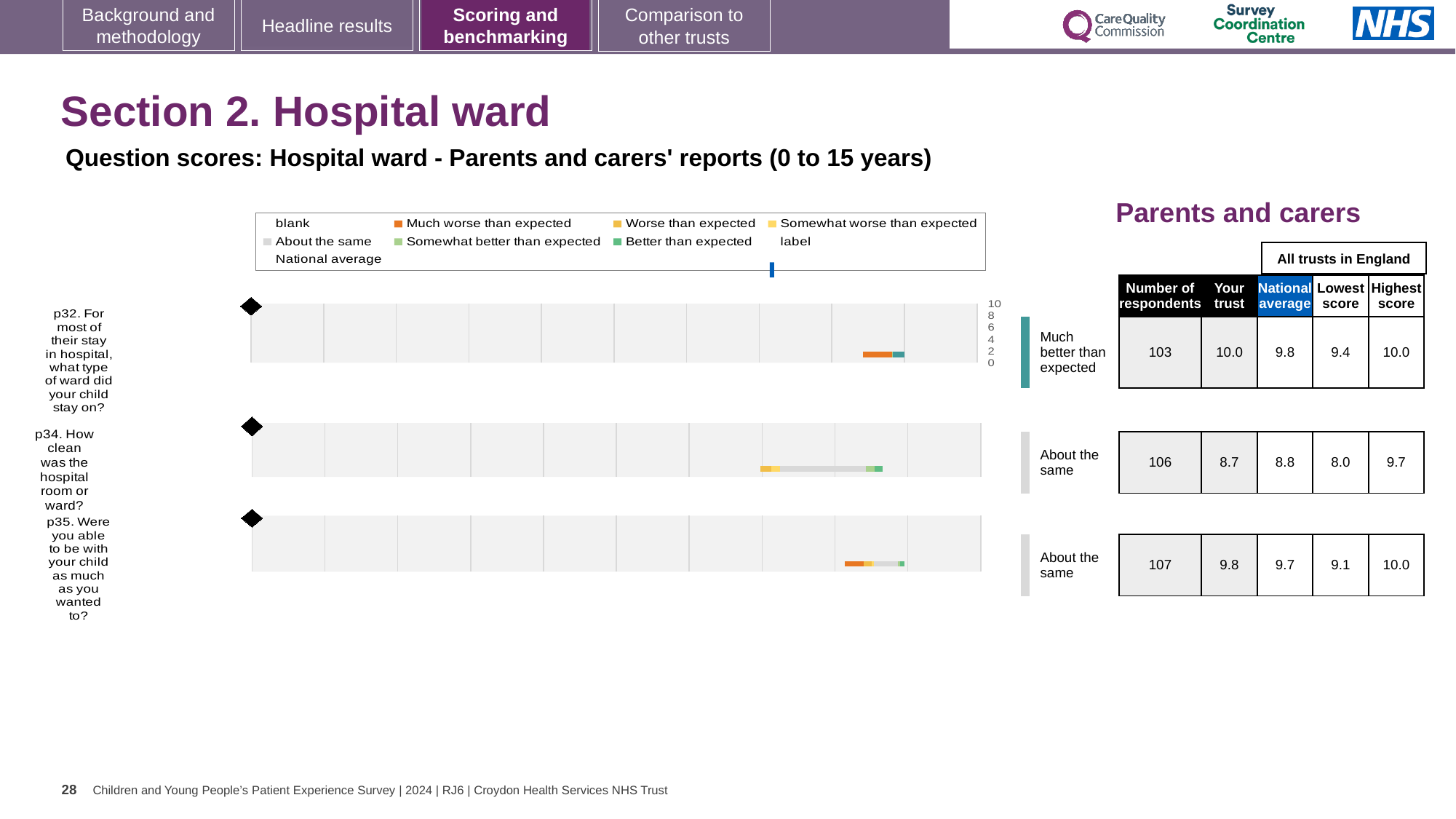
What is the difference between the highest score and the lowest score for p34? 1.7 What kind of chart is used to show the question scores for the hospital ward section? bar chart Which question has the lowest 'Your trust' score? p34 By how much does the 'Your trust' score for p35 exceed the national average for p35? 0.1 What benchmarking category is shown for p32? Much better than expected How many questions are plotted in the hospital ward chart? 3 Which has the higher 'Your trust' score, p32 or p35? p32 What is the lowest score among all trusts in England for p32? 9.4 Which question has the highest 'Your trust' score? p32 What is the 'Your trust' score for p32 (what type of ward did your child stay on)? 10.0 How many respondents answered p35 (were you able to be with your child as much as you wanted to)? 107 What is the national average score for p34 (how clean was the hospital room or ward)? 8.8